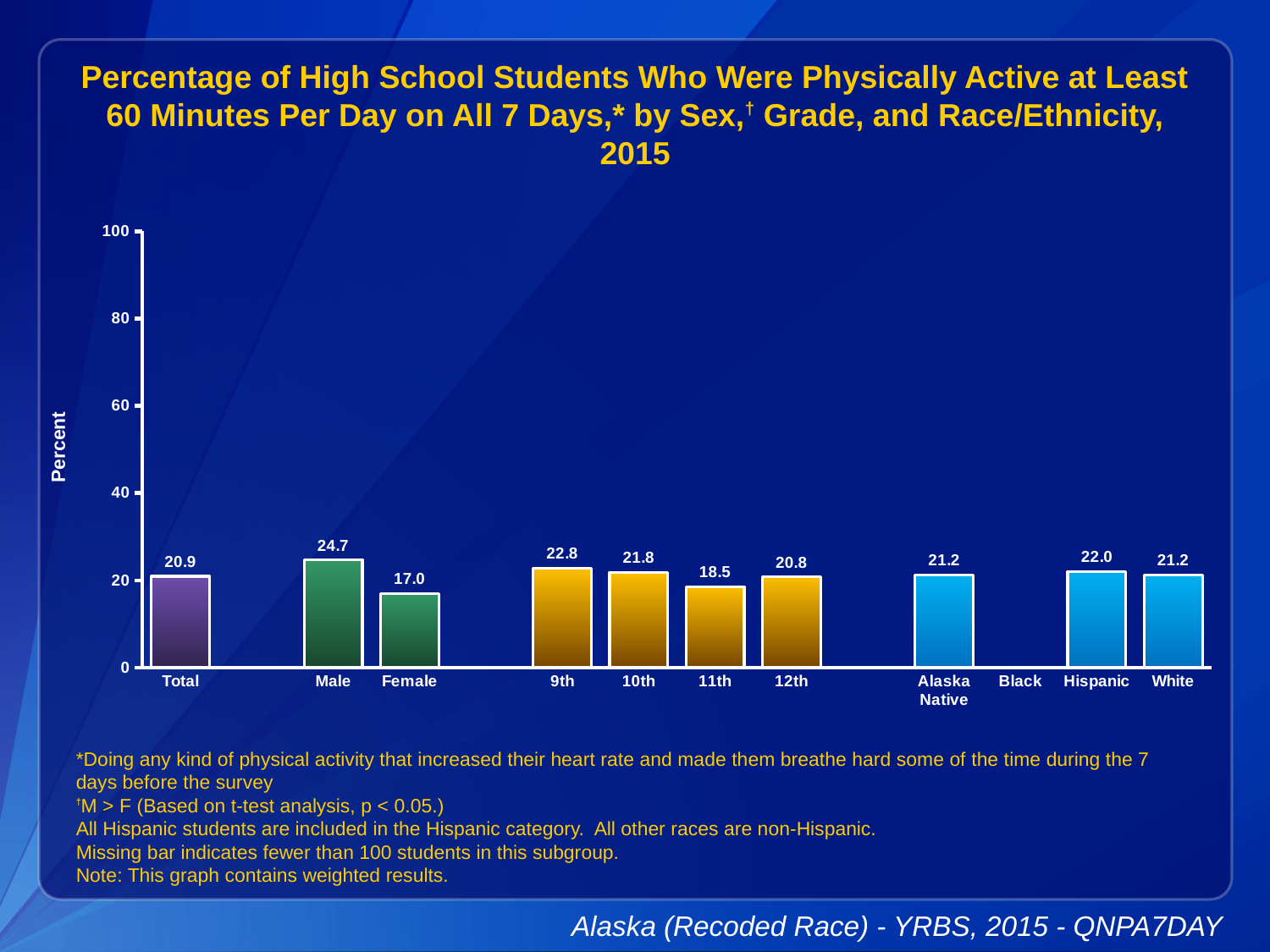
What kind of chart is shown? bar chart What is the value for Hispanic? 22.0 Which category on the x axis has no bar? Black Is the value for Male greater or less than 20? greater What is the value for Total? 20.9 Which category has the highest value? Male What is the value for Female? 17.0 What is the difference between the Male and Female values? 7.7 What is the value for 11th grade? 18.5 How many categories are labeled on the x axis? 11 Which is larger, the value for 9th grade or the value for 12th grade? 9th Which category has the lowest value among the bars shown? Female